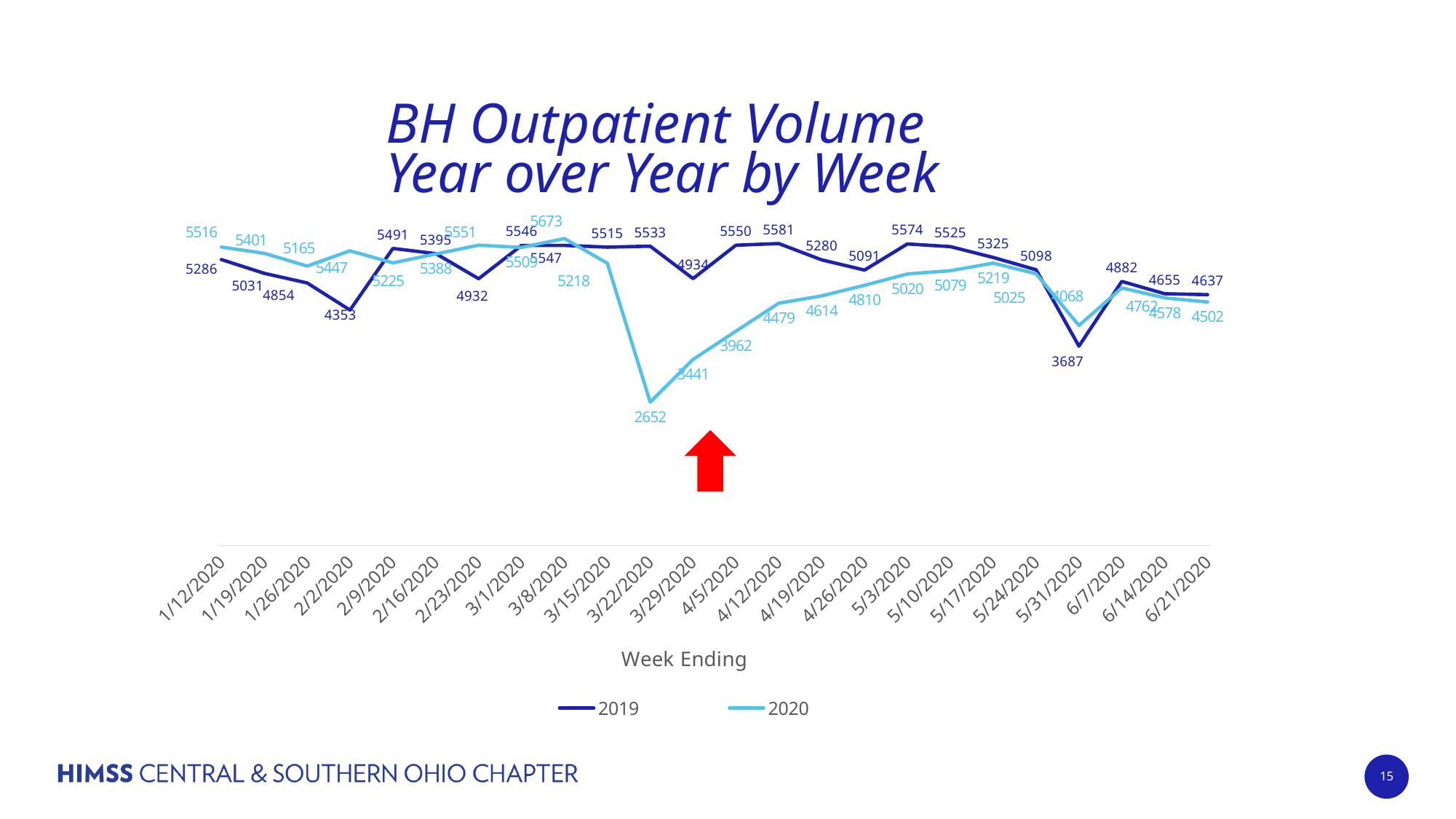
What is the 2019 value for the week ending 5/31/2020? 3687 What is the difference between the 2019 and 2020 values for the week ending 3/22/2020? 2881 How many week-ending dates are plotted along the x axis? 24 For which week ending is the 2020 value highest? 3/8/2020 For which week ending is the 2020 value lowest? 3/22/2020 For which week ending is the 2019 value lowest? 5/31/2020 How many series does the legend list? 2 For the week ending 2/2/2020, which series has the larger value, 2019 or 2020? 2020 What is the 2020 value for the week ending 3/22/2020? 2652 What is the 2019 value for the week ending 4/12/2020? 5581 Does the 2020 line rise or fall from the week ending 3/22/2020 to the week ending 5/17/2020? rise What kind of chart is shown on the slide? line chart